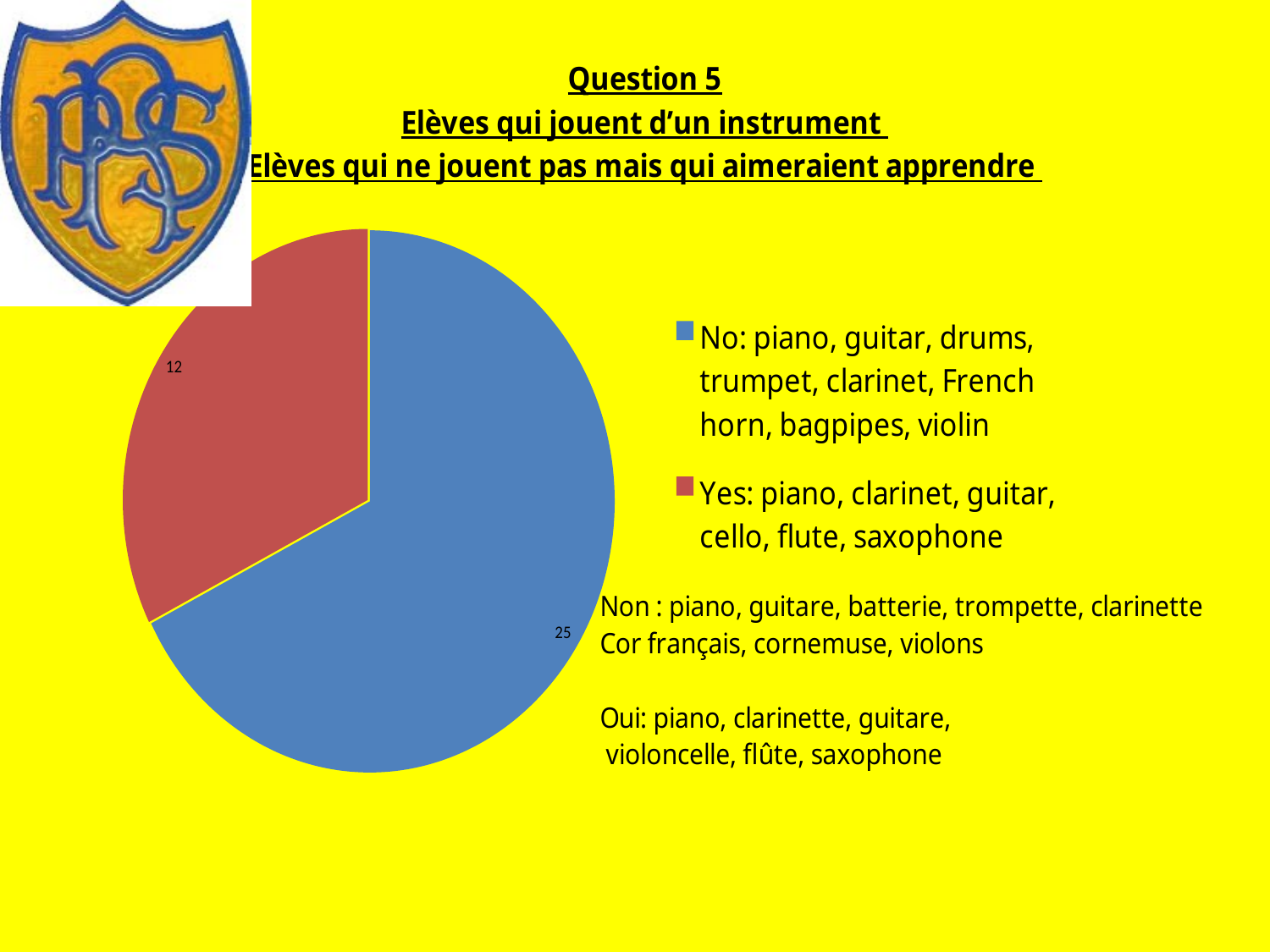
How many entries does the pie chart's legend list? 2 What colour is the 'No' slice of the pie chart? blue Which is larger in the pie chart, the 'No' slice or the 'Yes' slice? No What kind of chart is shown on the slide? pie chart How many slices does the pie chart have? 2 Which slice of the pie chart is the largest? No What value is shown for the 'Yes' slice of the pie chart? 12 What value is shown for the 'No' slice of the pie chart? 25 What is the total of the two values shown in the pie chart? 37 What is the difference between the 'No' value and the 'Yes' value in the pie chart? 13 What colour is the 'Yes' slice of the pie chart? red Which slice of the pie chart is the smallest? Yes